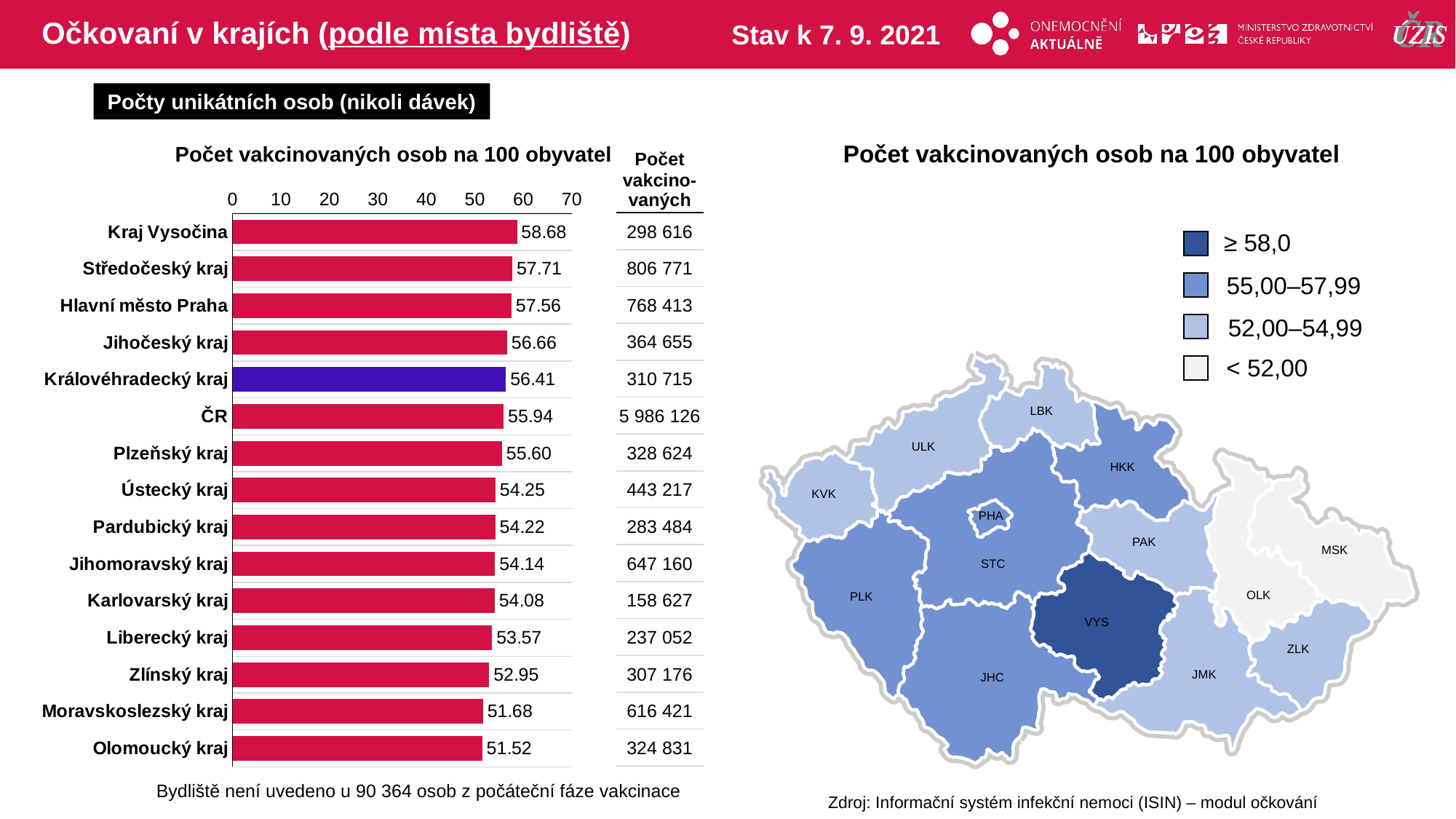
In the bar chart 'Počet vakcinovaných osob na 100 obyvatel', is the value for Moravskoslezský kraj greater or less than 60? less In the bar chart 'Počet vakcinovaných osob na 100 obyvatel', what is the value for Kraj Vysočina? 58.68 In the bar chart 'Počet vakcinovaných osob na 100 obyvatel', which bar is coloured differently (blue) from the others? Královéhradecký kraj In the bar chart 'Počet vakcinovaných osob na 100 obyvatel', which category has the lowest value? Olomoucký kraj In the bar chart 'Počet vakcinovaných osob na 100 obyvatel', which is larger: the value for Plzeňský kraj or the value for Liberecký kraj? Plzeňský kraj In the bar chart 'Počet vakcinovaných osob na 100 obyvatel', what is the difference between the values for Kraj Vysočina and Olomoucký kraj? 7.16 In the bar chart 'Počet vakcinovaných osob na 100 obyvatel', which category has the highest value? Kraj Vysočina What kind of chart is used on the left side of the slide to show 'Počet vakcinovaných osob na 100 obyvatel'? bar chart How many categories (bars) are shown in the bar chart 'Počet vakcinovaných osob na 100 obyvatel'? 15 In the bar chart 'Počet vakcinovaných osob na 100 obyvatel', what is the value for ČR? 55.94 In the table column 'Počet vakcinovaných' next to the bar chart, what is the value for Středočeský kraj? 806 771 In the bar chart 'Počet vakcinovaných osob na 100 obyvatel', what is the value for Královéhradecký kraj? 56.41